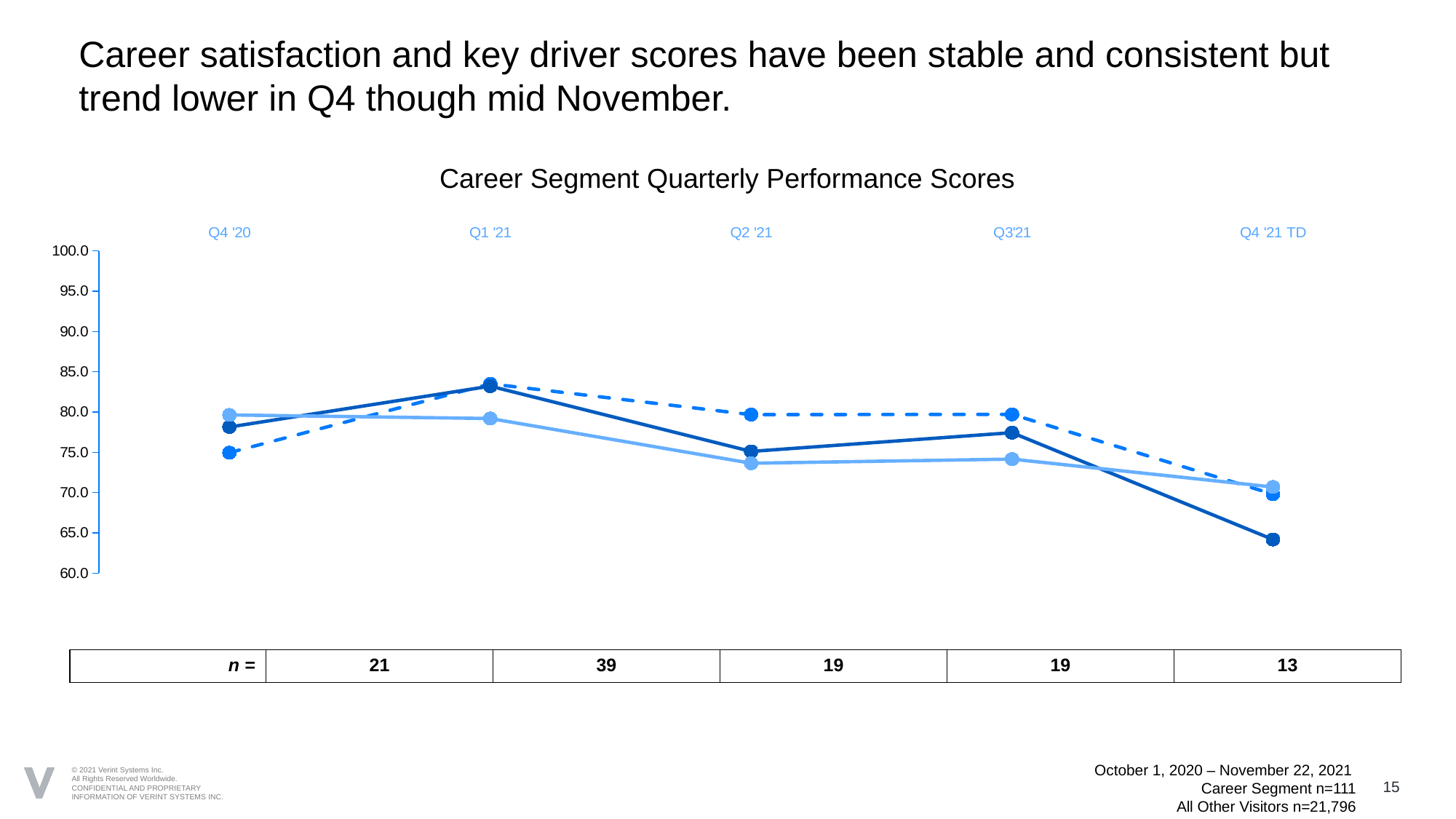
What kind of chart is shown on the slide? line chart How many quarters are plotted along the x axis of the chart? 5 What is the title of the chart? Career Segment Quarterly Performance Scores In which quarter does the dark blue solid line reach its highest value? Q1 '21 Is the value of the light blue solid line at Q2 '21 greater or less than 75.0? less In which quarter does the dark blue solid line reach its lowest value? Q4 '21 TD Is the value of the dashed line at Q1 '21 greater or less than 80.0? greater How many lines are plotted on the chart? 3 What is the n value shown for Q1 '21 in the table below the chart? 39 At Q4 '21 TD, which is higher: the dark blue solid line or the light blue solid line? the light blue solid line Does the dark blue solid line rise or fall from Q3'21 to Q4 '21 TD? fall Is the value of the dark blue solid line at Q4 '21 TD greater or less than 70.0? less